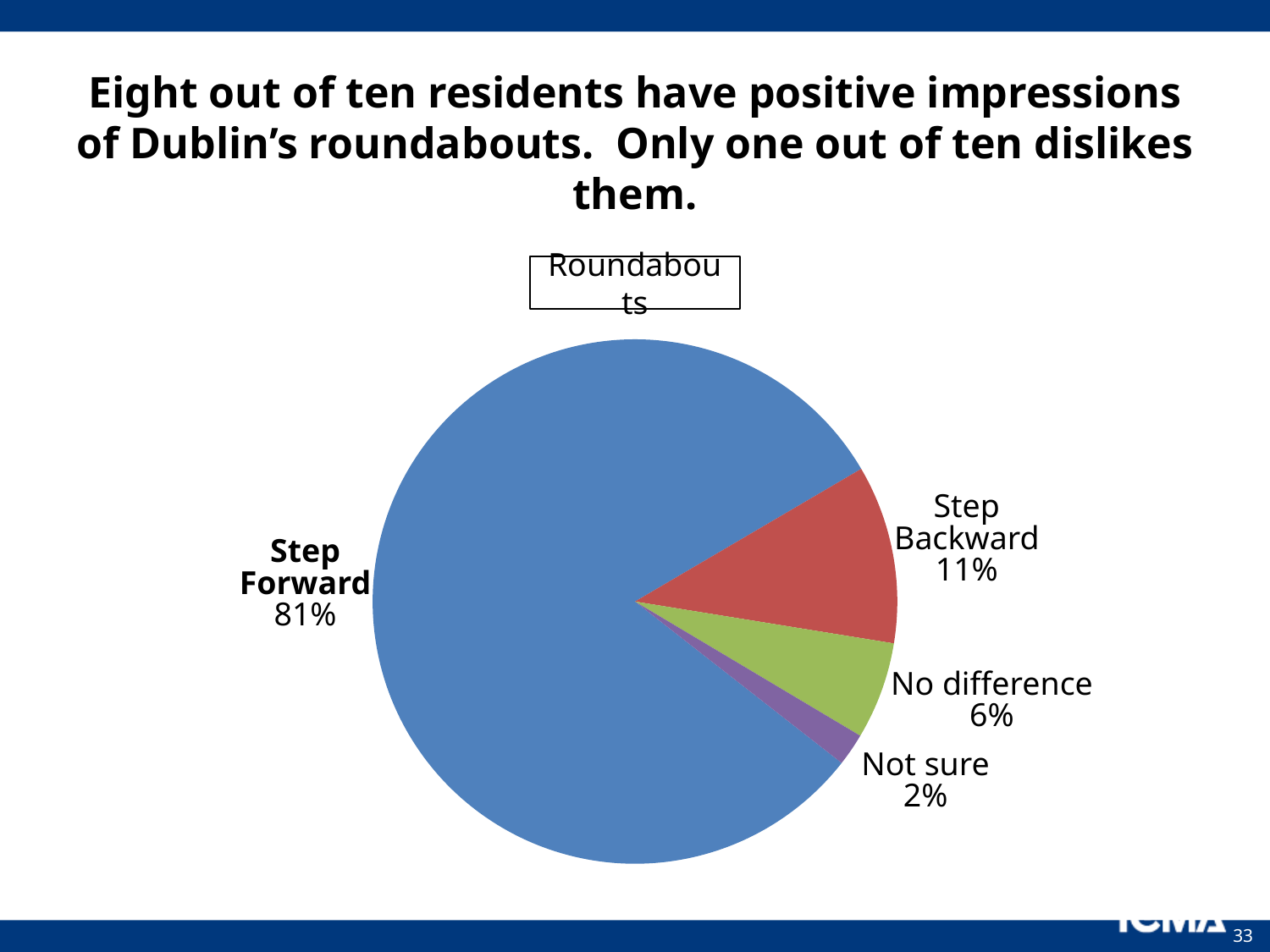
Which is larger, the share for No difference or the share for Not sure? No difference What percentage of residents consider the roundabouts a Step Forward? 81% Which response has the largest share of the pie? Step Forward What percentage of residents said the roundabouts make No difference? 6% What is the difference in percentage points between Step Backward and No difference? 5 What colour is the Step Forward slice? Blue What percentage of residents consider the roundabouts a Step Backward? 11% Which response has the smallest share of the pie? Not sure What percentage of residents were Not sure about the roundabouts? 2% What type of chart is shown on the slide? Pie chart How many slices does the pie chart have? 4 What is the difference in percentage points between Step Forward and Step Backward? 70